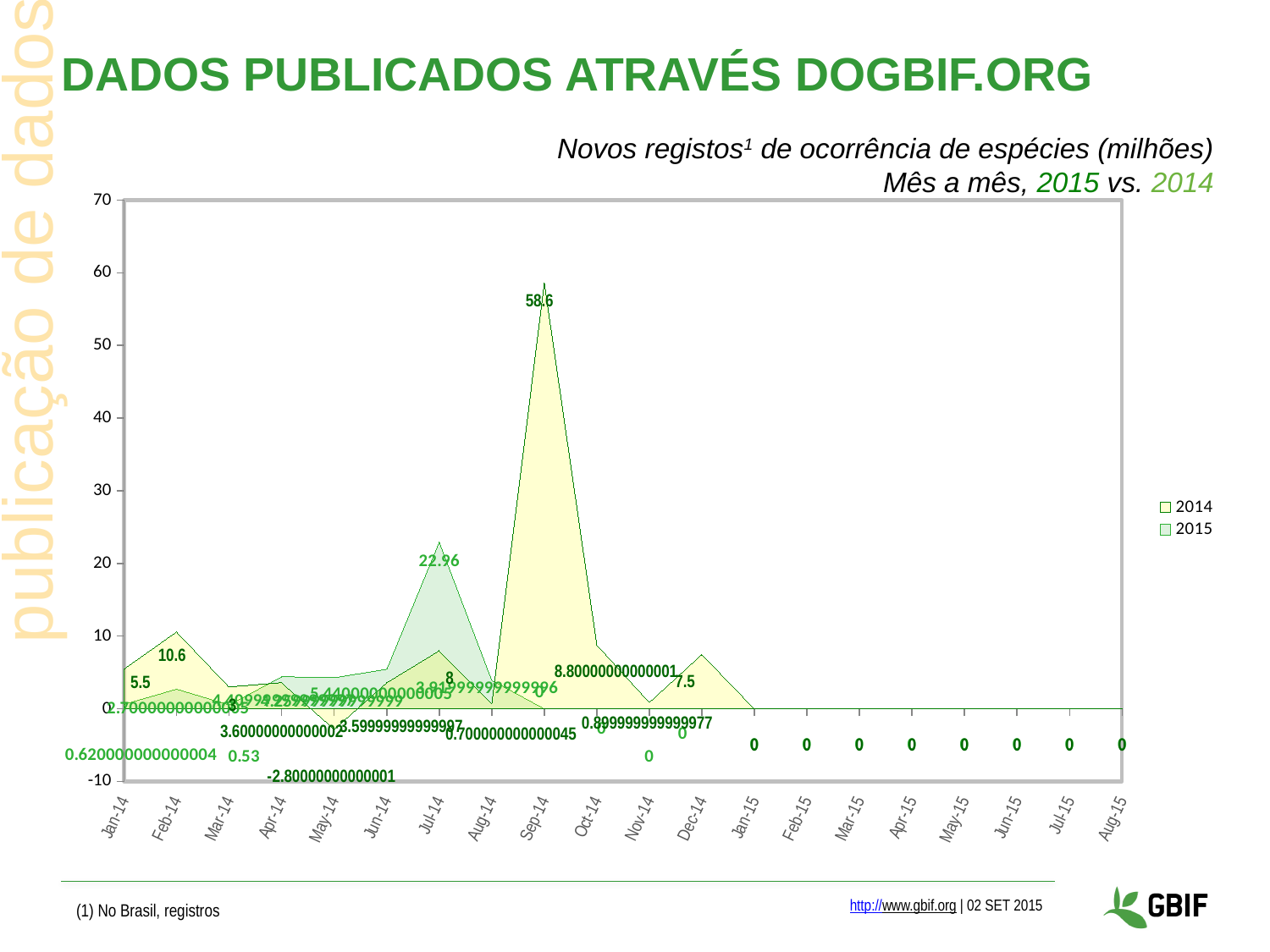
What is the 2014 value for Sep-14? 58.6 What is the 2014 value for Dec-14? 7.5 In which month does the 2014 series reach its highest value? Sep-14 Is the 2014 value for Sep-14 greater or less than 50? greater What is the 2014 value for Feb-14? 10.6 How many months are shown along the x axis? 20 How many series does the legend list? 2 Which is larger: the 2014 value for Sep-14 or the 2015 value for Jul-14? the 2014 value for Sep-14 What kind of chart is shown on the slide? area chart Which two series are listed in the legend? 2014 and 2015 What is the 2015 value for Jul-14? 22.96 In which month does the 2015 series reach its highest value? Jul-14